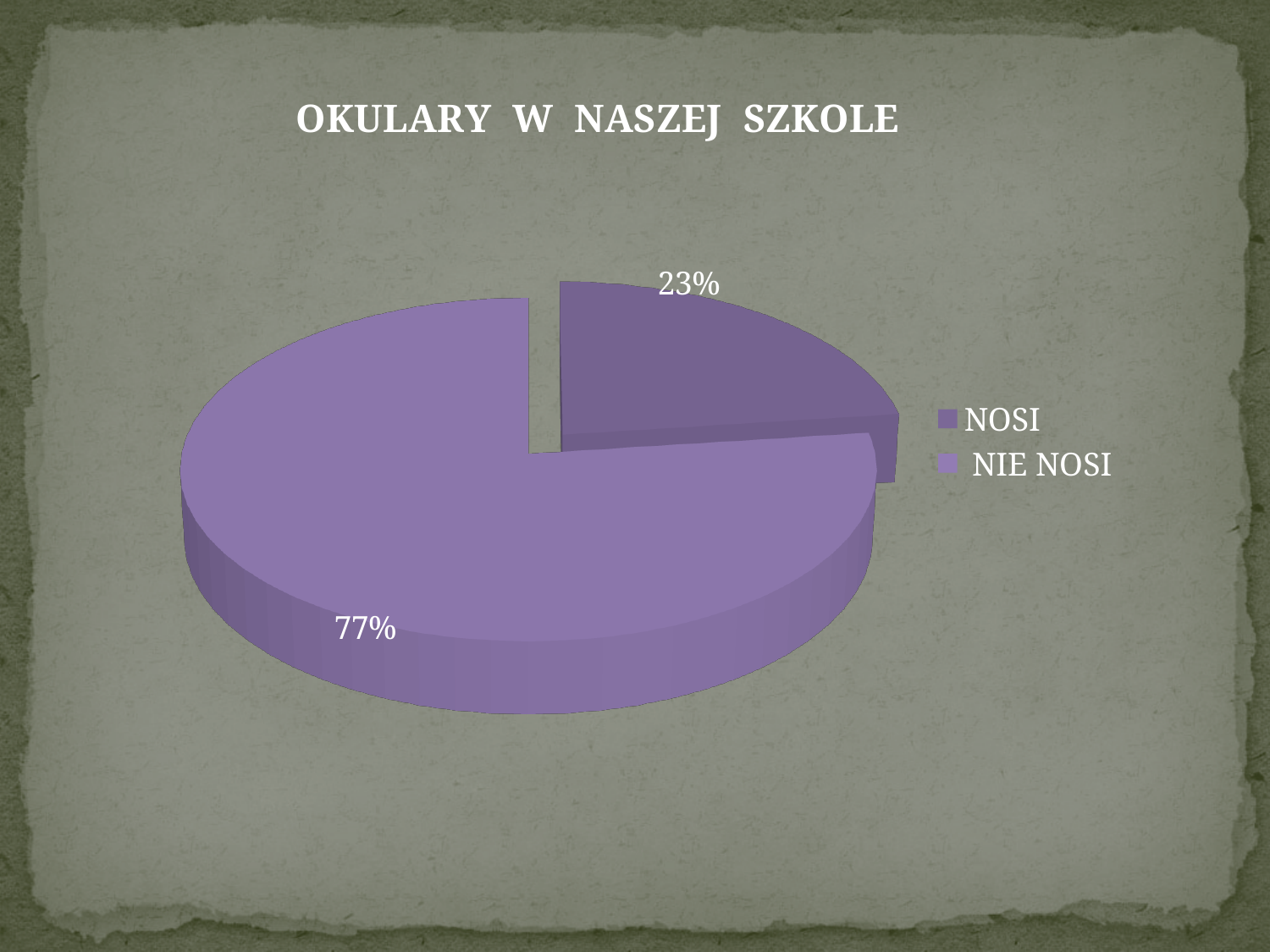
How many slices does the pie chart have? 2 What is the title of the chart? OKULARY W NASZEJ SZKOLE What type of chart is shown on the slide? Pie chart What is the difference in percentage points between NIE NOSI and NOSI? 54 Is the share for NOSI greater or less than 50%? less What percentage of the pie is labelled NOSI? 23% What are the two legend entries of the chart? NOSI and NIE NOSI How many entries does the legend list? 2 Which category has the smallest share of the pie? NOSI Which is larger, the share for NOSI or the share for NIE NOSI? NIE NOSI Which category has the largest share of the pie? NIE NOSI What percentage of the pie is labelled NIE NOSI? 77%